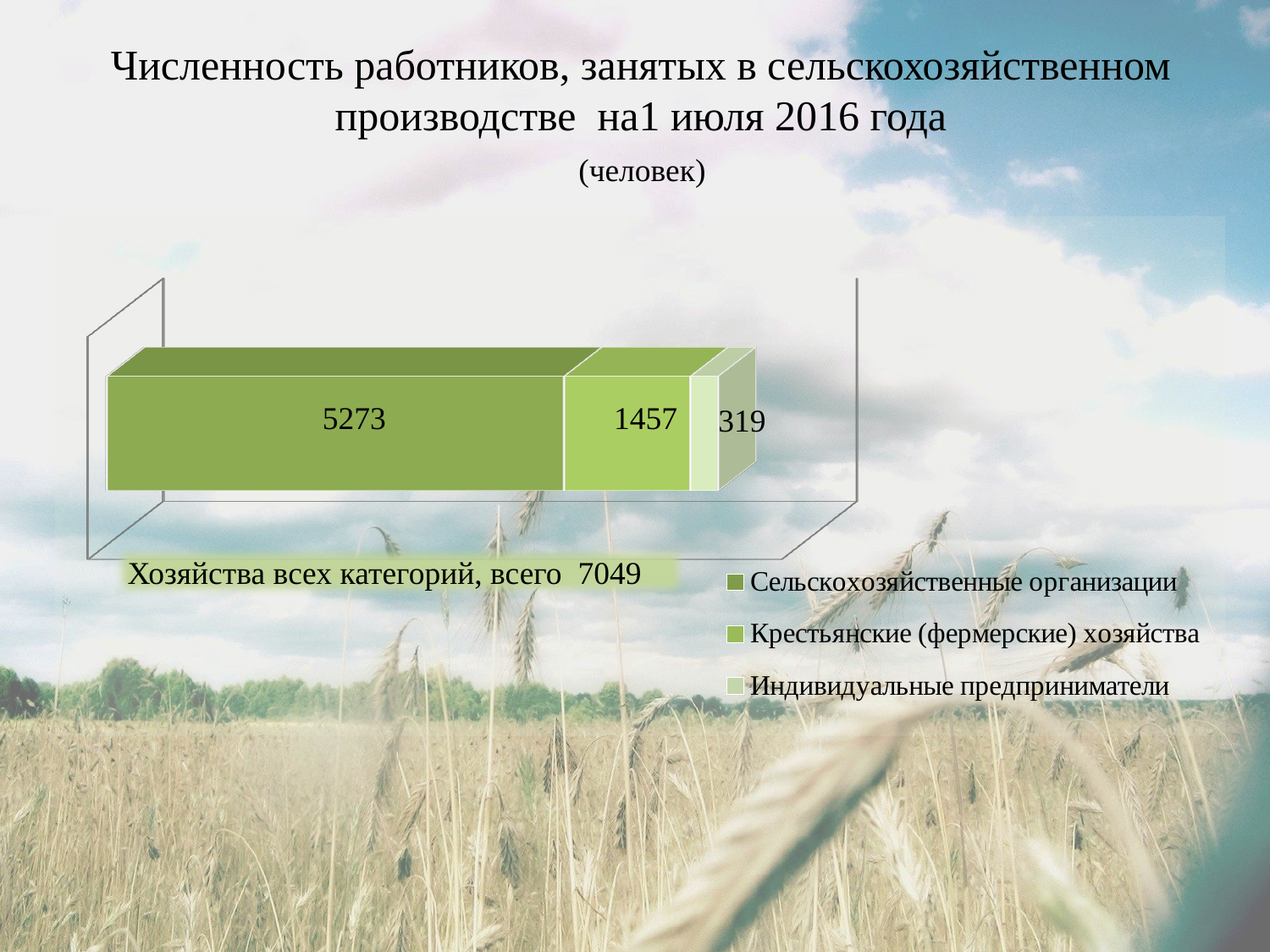
What is the difference between the values for Сельскохозяйственные организации and Крестьянские (фермерские) хозяйства? 3816 What is the total of the stacked bar for Хозяйства всех категорий? 7049 What unit is given in parentheses under the chart title? человек What is the value for Индивидуальные предприниматели? 319 What is the value for Сельскохозяйственные организации? 5273 Which series has the lowest value? Индивидуальные предприниматели Which series has the highest value? Сельскохозяйственные организации What kind of chart is shown on the slide? Stacked bar chart Which is larger: the value for Крестьянские (фермерские) хозяйства or Индивидуальные предприниматели? Крестьянские (фермерские) хозяйства How many series does the legend list? 3 What is the value for Крестьянские (фермерские) хозяйства? 1457 What is the difference between the values for Крестьянские (фермерские) хозяйства and Индивидуальные предприниматели? 1138